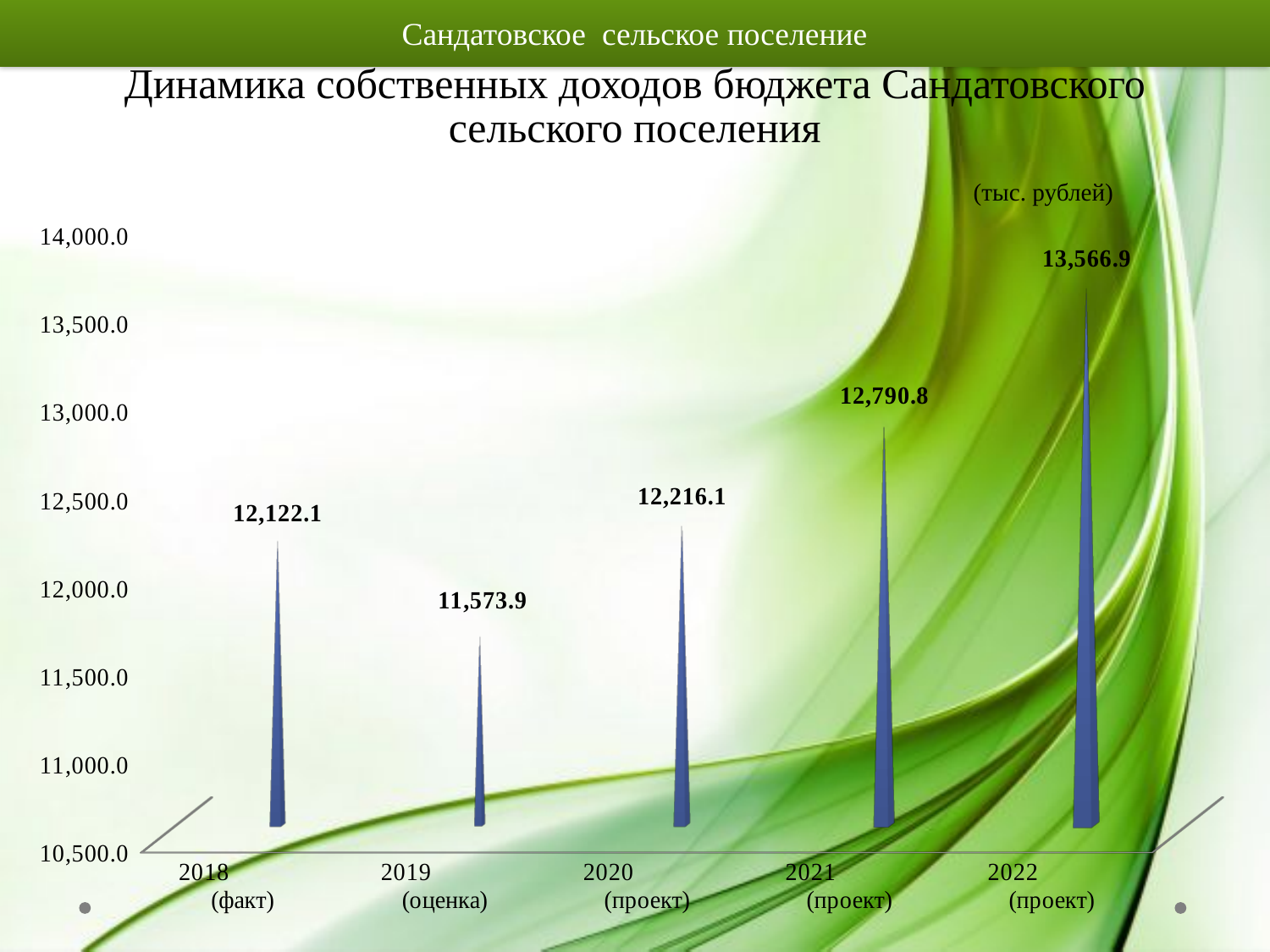
What is the value for 2021 (проект)? 12,790.8 What is the difference between the values for 2022 (проект) and 2021 (проект)? 776.1 Which year has the lowest value? 2019 (оценка) From 2019 (оценка) to 2022 (проект), do the values rise or fall? rise What is the difference between the values for 2018 (факт) and 2019 (оценка)? 548.2 Is the value for 2021 (проект) greater or less than 13,000.0? less What is the value for 2018 (факт)? 12,122.1 What kind of chart is shown on the slide? bar chart What is the value for 2019 (оценка)? 11,573.9 Which year has the highest value? 2022 (проект) How many years are shown on the x axis? 5 Which is larger, the value for 2018 (факт) or the value for 2020 (проект)? 2020 (проект)